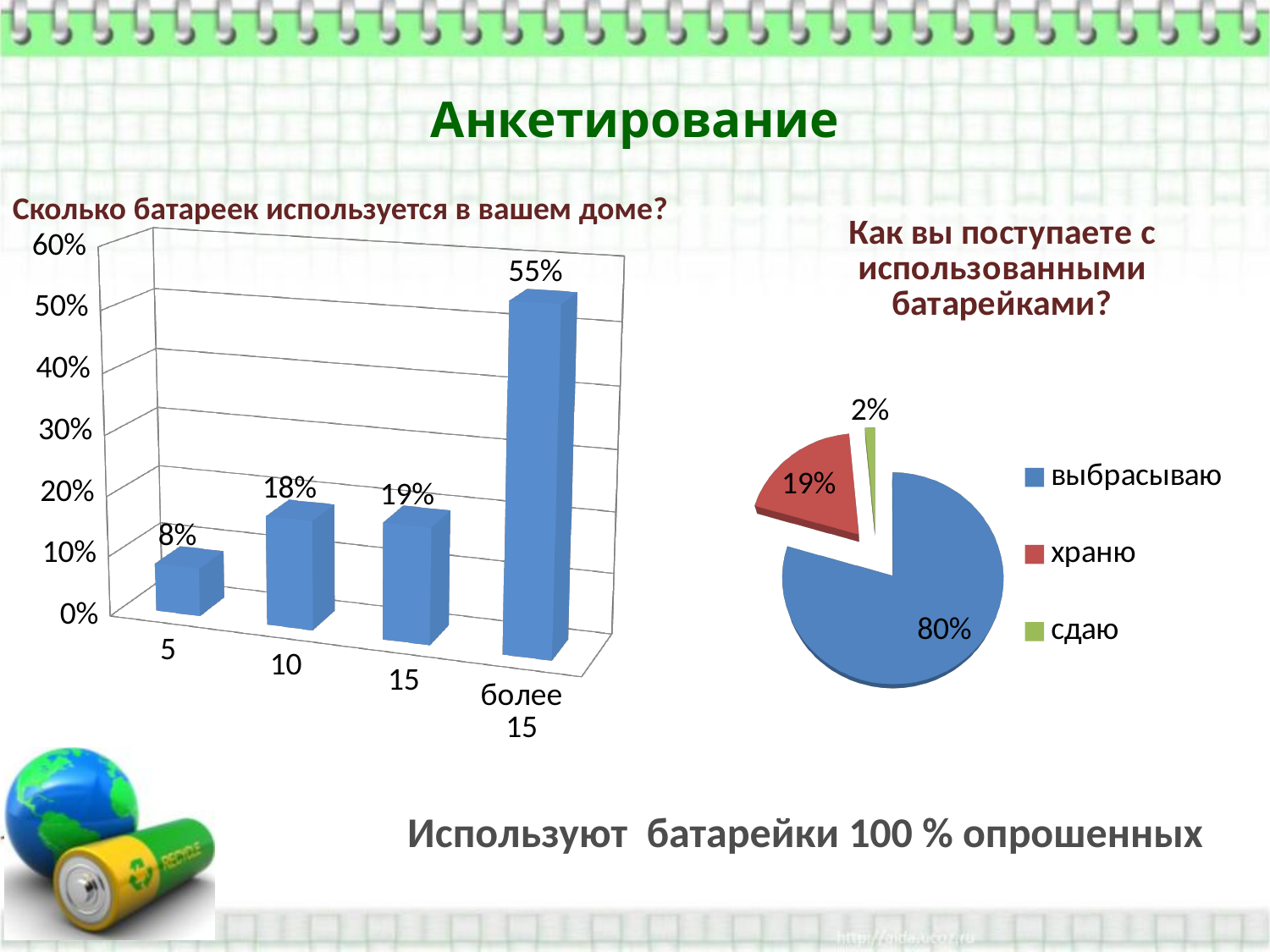
In the pie chart "Как вы поступаете с использованными батарейками?", which slice is the largest? выбрасываю In the pie chart "Как вы поступаете с использованными батарейками?", how many entries does the legend list? 3 What kind of chart is the one on the left titled "Сколько батареек используется в вашем доме?"? bar chart In the bar chart "Сколько батареек используется в вашем доме?", what is the value for the category "5"? 8% In the pie chart "Как вы поступаете с использованными батарейками?", what colour is the "сдаю" slice? green In the bar chart "Сколько батареек используется в вашем доме?", how many categories are shown on the x axis? 4 In the pie chart "Как вы поступаете с использованными батарейками?", what share does "храню" have? 19% In the bar chart "Сколько батареек используется в вашем доме?", which category has the lowest value? 5 In the bar chart "Сколько батареек используется в вашем доме?", what is the value for the category "более 15"? 55% In the bar chart "Сколько батареек используется в вашем доме?", what is the difference between the values for "более 15" and "5"? 47% In the bar chart "Сколько батареек используется в вашем доме?", do the values rise or fall from left to right along the x axis? rise In the bar chart "Сколько батареек используется в вашем доме?", which category has the highest value? более 15